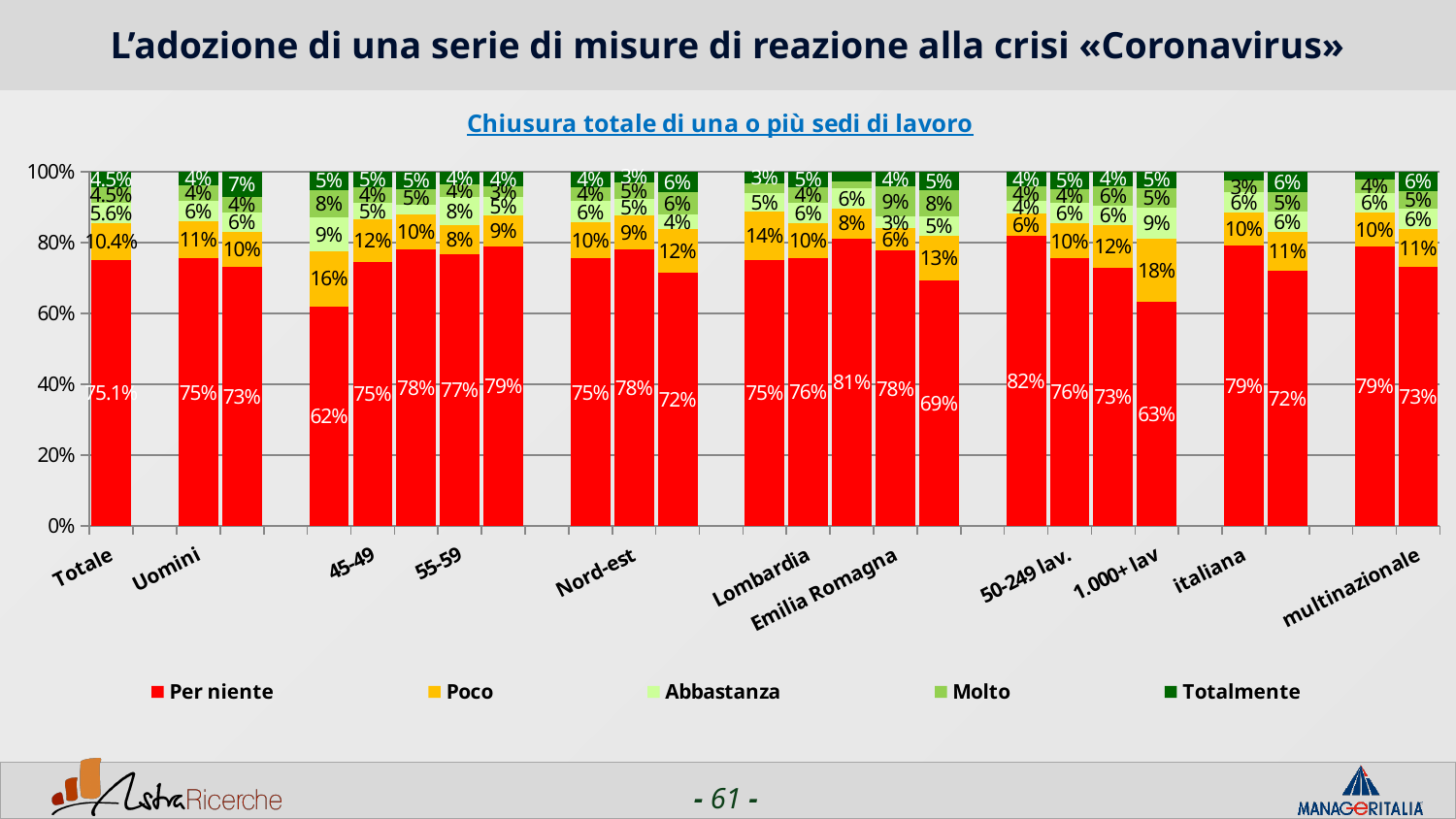
Which has a larger 'Per niente' value, italiana or multinazionale? italiana What kind of chart is shown on the slide? Stacked bar chart What is the 'Per niente' value for Totale? 75.1% What is the 'Poco' value for Uomini? 11% What is the 'Per niente' value for 1.000+ lav? 63% Is the 'Per niente' value for 1.000+ lav greater or less than 80%? less What is the 'Per niente' value for Emilia Romagna? 78% What is the 'Poco' value for 1.000+ lav? 18% What is the difference between the 'Per niente' values for italiana and multinazionale? 6 percentage points What is the 'Poco' value for Totale? 10.4% How many series does the legend list? 5 What is the chart's title (the subtitle above the chart)? Chiusura totale di una o più sedi di lavoro